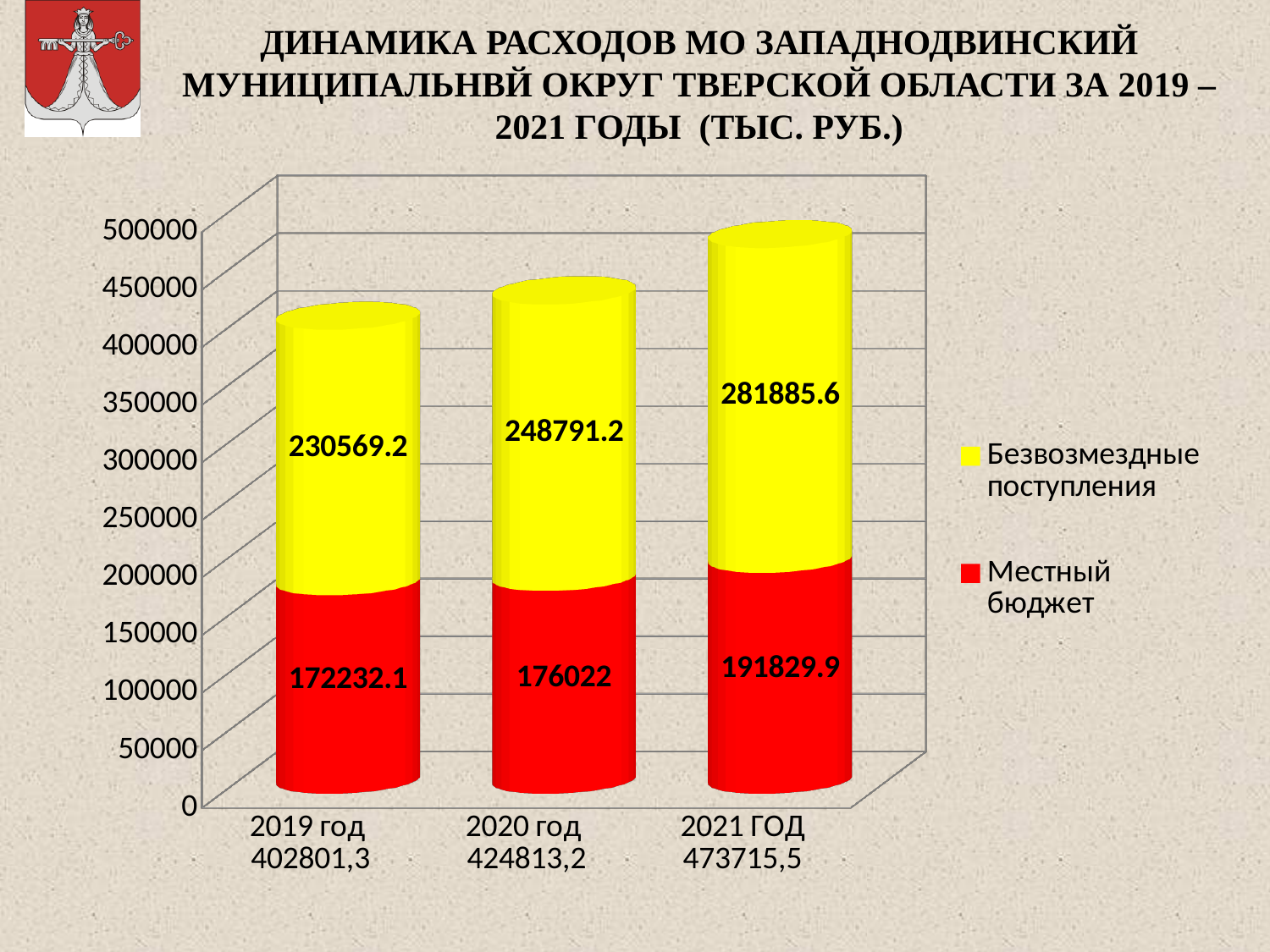
What is the difference between Безвозмездные поступления in 2021 ГОД and in 2020 год? 33094.4 What is the value of Местный бюджет for 2019 год? 172232.1 What is the difference between Безвозмездные поступления and Местный бюджет in 2019 год? 58337.1 What is the value of Местный бюджет for 2021 ГОД? 191829.9 How many series does the legend list? 2 Which is larger in 2020 год: Безвозмездные поступления or Местный бюджет? Безвозмездные поступления Do the values for Местный бюджет rise or fall from 2019 to 2021? rise What is the value of Безвозмездные поступления for 2020 год? 248791.2 Which year has the lowest value for Местный бюджет? 2019 год What is the total of the stacked bar for 2021 ГОД? 473715.5 How many years (categories) are shown on the x axis? 3 Which year has the highest value for Безвозмездные поступления? 2021 ГОД